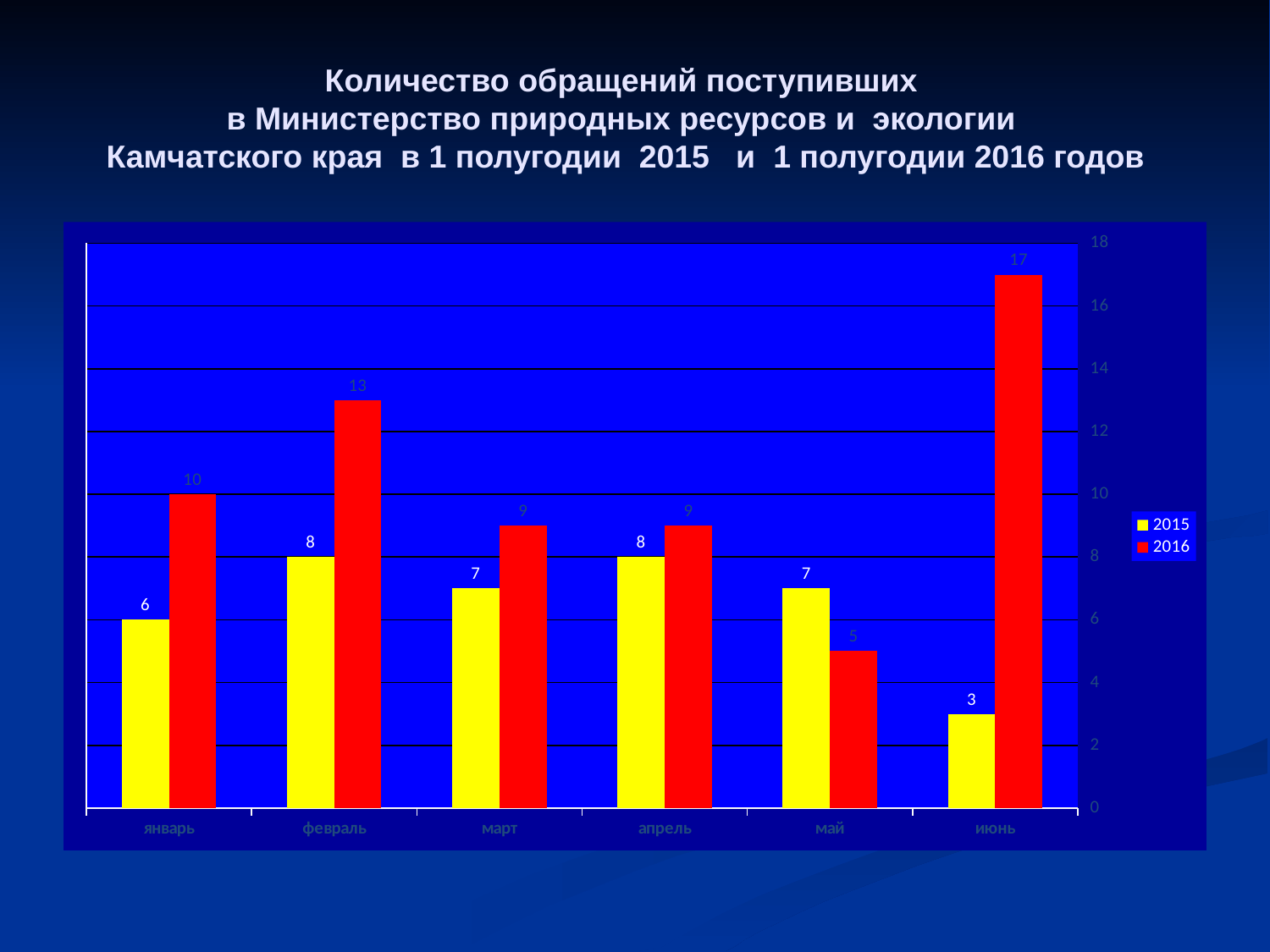
What is the difference between the 2016 and 2015 values in февраль? 5 In май, which series has the larger value, 2015 or 2016? 2015 Which colour represents the 2016 series in the legend? red Which month has the lowest value for the 2015 series? июнь What type of chart is shown on the slide? bar chart What is the value for 2016 in июнь? 17 What is the value for 2016 in февраль? 13 How many months are shown on the x axis? 6 How many series does the legend list? 2 Which month has the highest value for the 2016 series? июнь What is the value for 2015 in январь? 6 What is the difference between the 2016 and 2015 values in июнь? 14